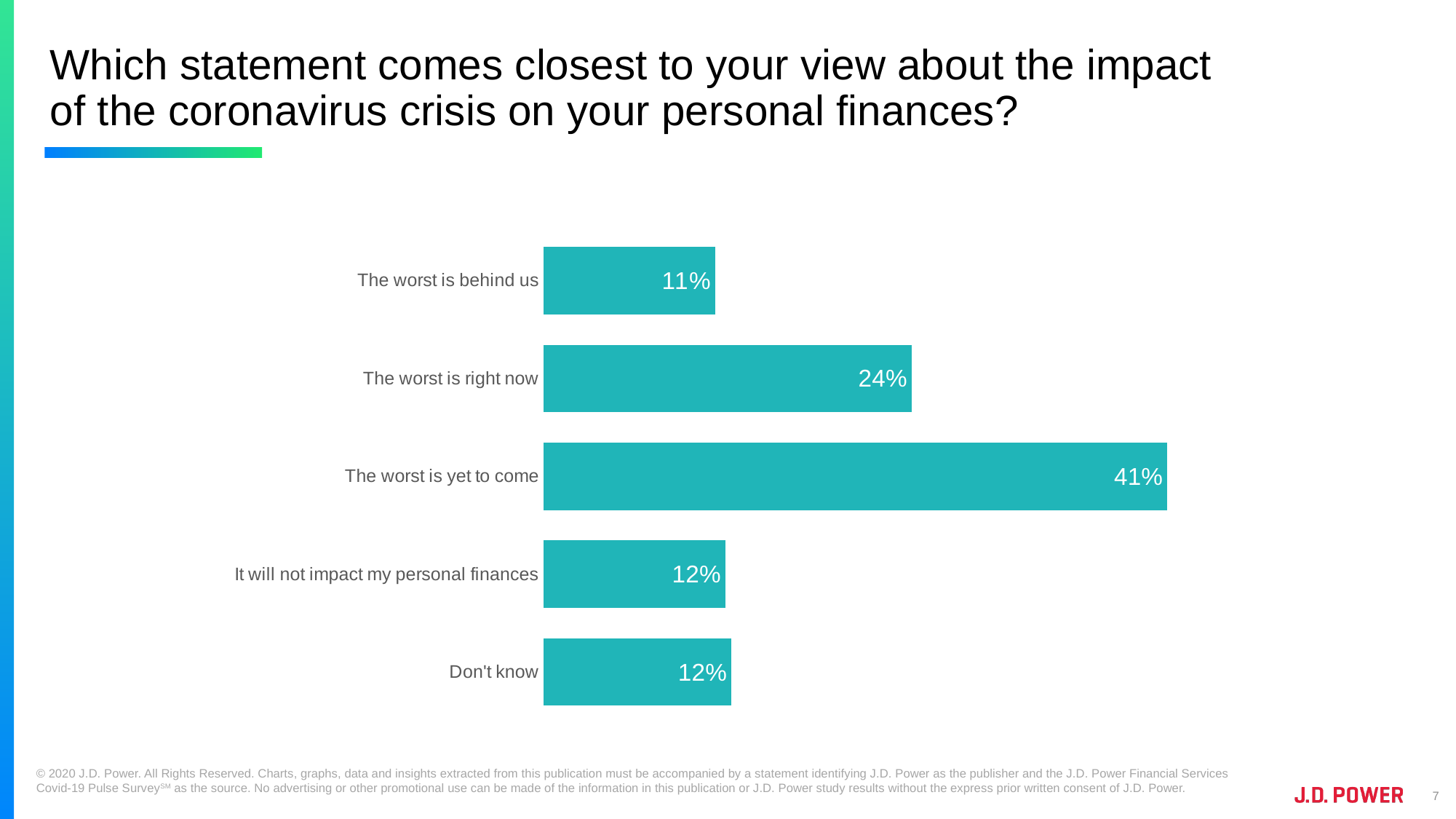
Which statement received the highest share of responses? The worst is yet to come What percentage of respondents said "The worst is behind us"? 11% What percentage of respondents said "The worst is right now"? 24% What is the difference in percentage points between "The worst is yet to come" and "The worst is right now"? 17 What percentage of respondents answered "Don't know"? 12% How many statements (categories) are shown in the chart? 5 Which has a larger share: "The worst is right now" or "It will not impact my personal finances"? The worst is right now What is the combined percentage for "It will not impact my personal finances" and "Don't know"? 24% What type of chart is shown on the slide? Bar chart What percentage of respondents said "The worst is yet to come"? 41% What colour are the bars in the chart? Teal Which statement received the lowest share of responses? The worst is behind us